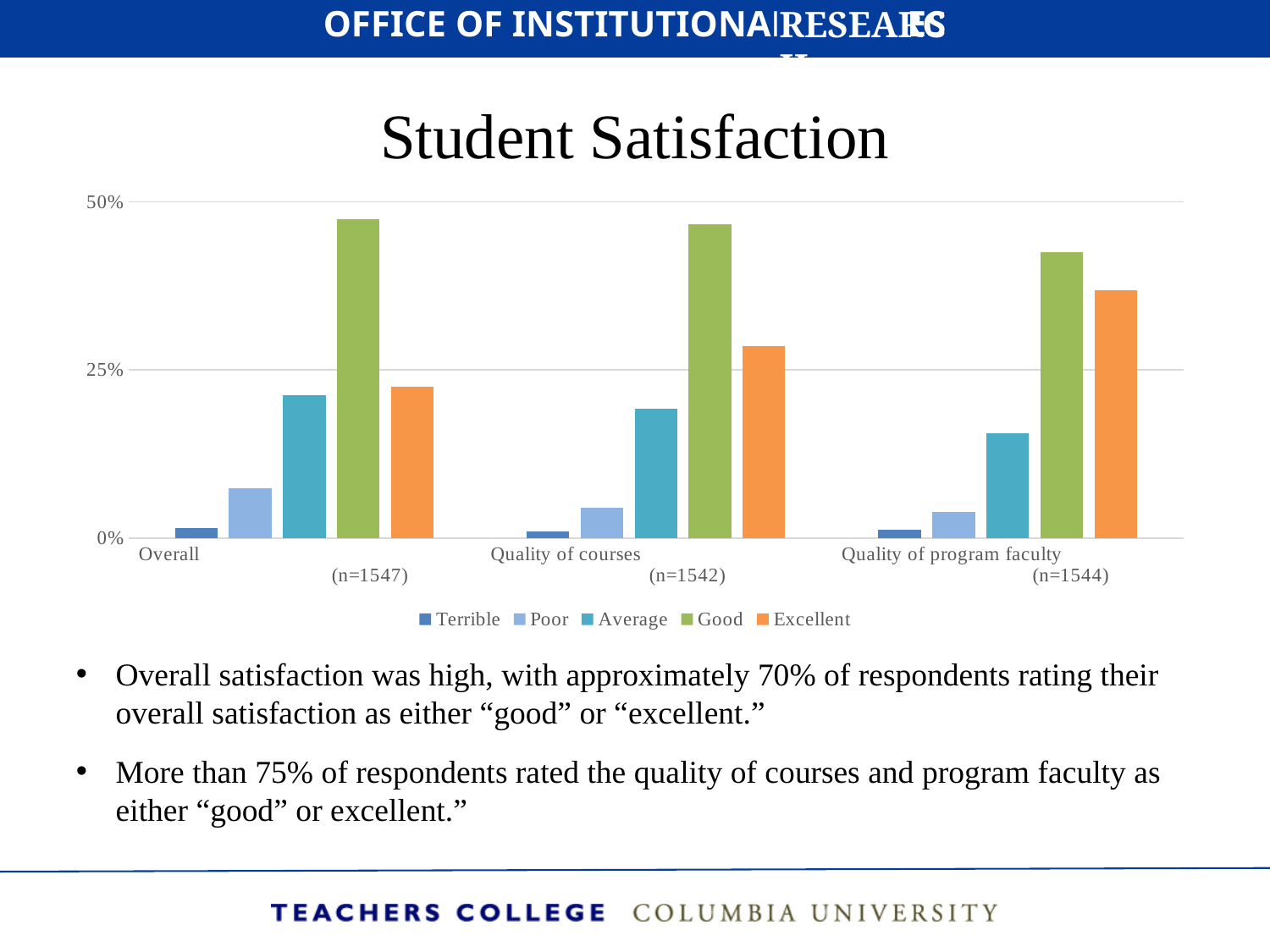
Which category has the tallest Excellent bar? Quality of program faculty What kind of chart is shown on the slide? bar chart How many series does the chart's legend list? 5 In the Quality of program faculty category, which is larger: the Good bar or the Excellent bar? Good What is the title of the chart? Student Satisfaction Is the value for Good in the Quality of courses category greater or less than 50%? less How many categories are shown along the x axis of the chart? 3 Which rating has the tallest bar in the Overall category? Good Is the value for Excellent in the Overall category greater or less than 25%? less Is the value for Excellent in the Quality of program faculty category greater or less than 25%? greater Which rating has the shortest bar in the Quality of courses category? Terrible